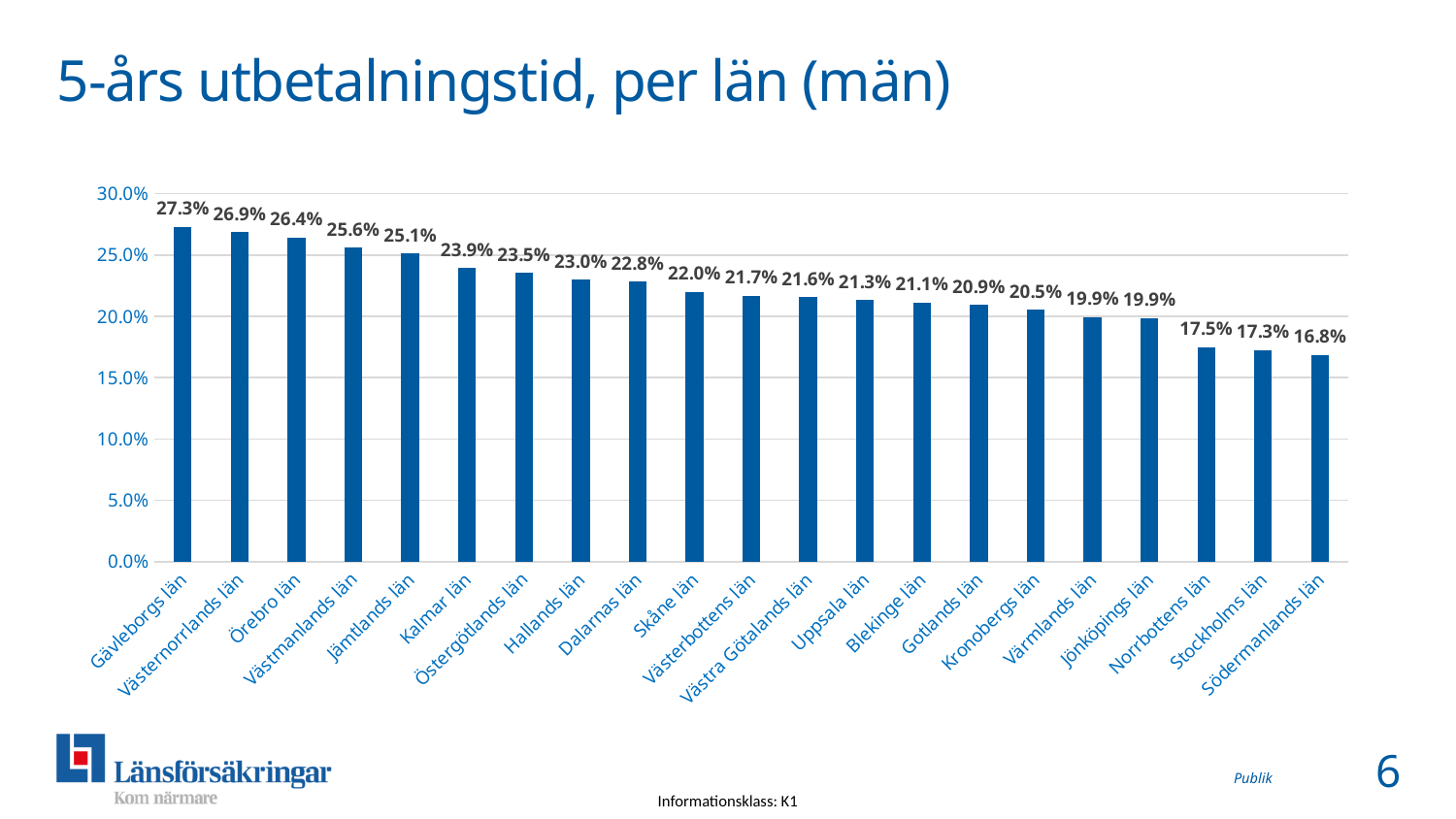
What is the value for Gävleborgs län? 27.3% What is the value for Stockholms län? 17.3% Is the value for Norrbottens län greater or less than 20.0%? less What kind of chart is shown on the slide? Bar chart What is the value for Skåne län? 22.0% Which county (län) has the lowest value? Södermanlands län What is the difference between the values for Gävleborgs län and Södermanlands län? 10.5 percentage points How many counties (län) are shown in the chart? 21 Do the values rise or fall from left to right along the x axis? Fall Which county (län) has the highest value? Gävleborgs län Which has a higher value, Kalmar län or Uppsala län? Kalmar län What is the title of the chart on the slide? 5-års utbetalningstid, per län (män)